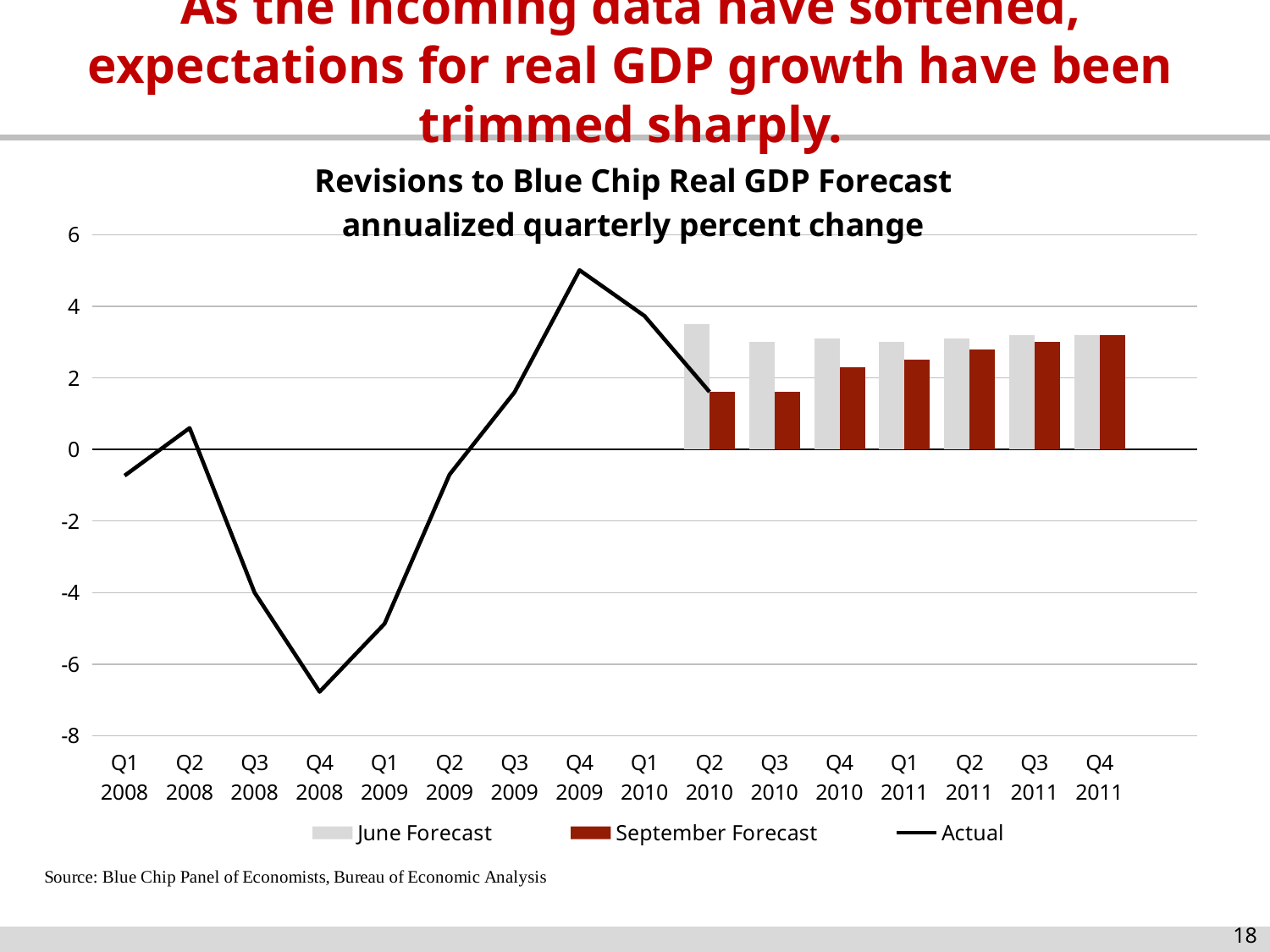
Do the September Forecast bars rise or fall from Q2 2010 to Q4 2011? rise For Q4 2010, which is larger, the June Forecast or the September Forecast? June Forecast What kind of chart is this? Combination of a line chart and a bar chart What are the three series named in the legend? June Forecast, September Forecast, Actual What is the title of the chart? Revisions to Blue Chip Real GDP Forecast annualized quarterly percent change In which quarter does the Actual line reach its highest value? Q4 2009 How many series does the legend list? 3 In which quarter does the Actual line reach its lowest value? Q4 2008 How many quarters are shown on the x axis? 16 Is the September Forecast value for Q2 2010 greater or less than 2? less Is the Actual value for Q4 2009 greater or less than 4? greater Is the Actual value for Q4 2008 greater or less than -6? less